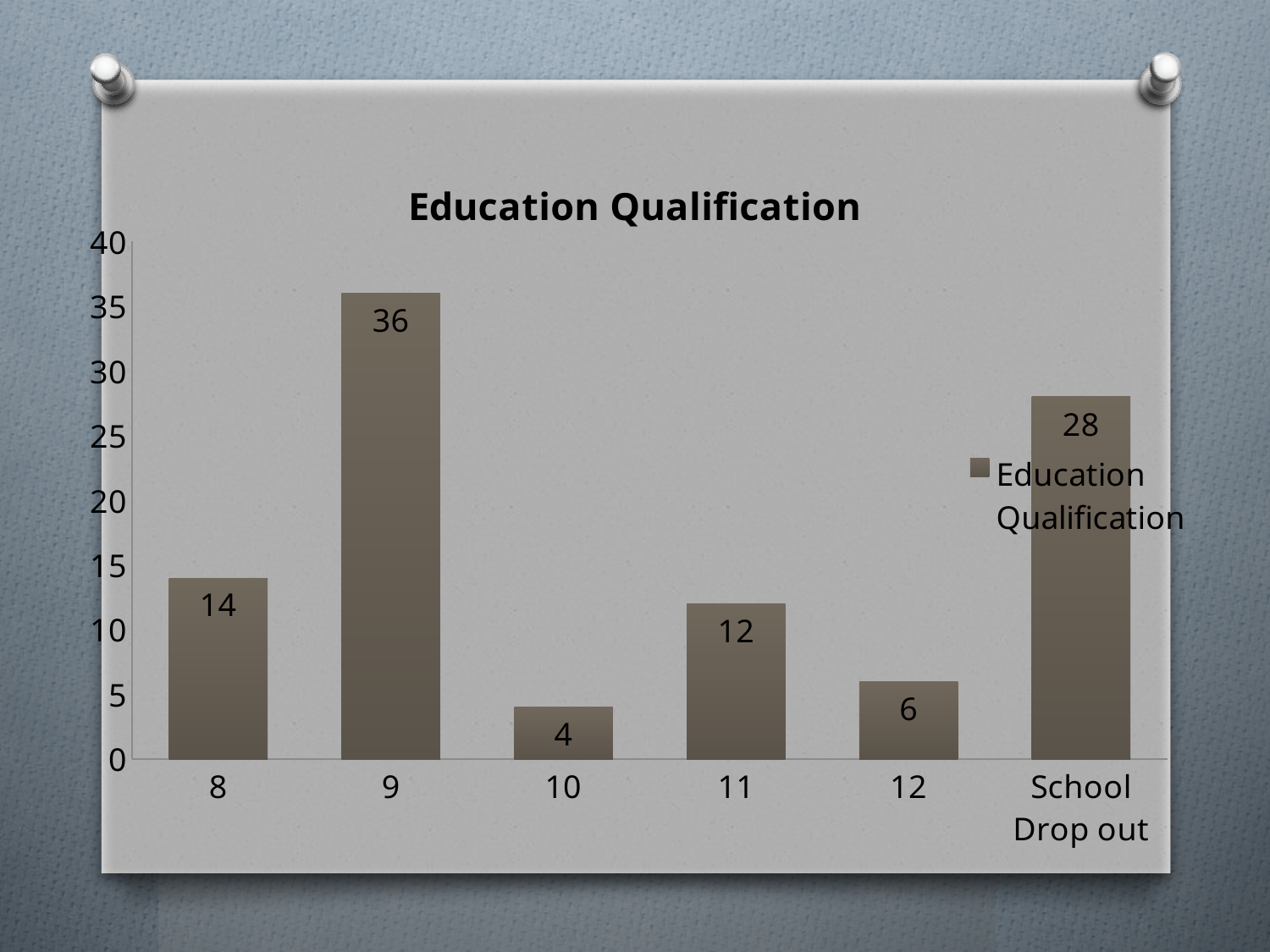
Which category has the highest value? 9 What is the difference between the values for 9 and School Drop out? 8 What is the value for category 9 in the Education Qualification chart? 36 Which category has the lowest value? 10 Is the value for School Drop out greater or less than 25? greater What is the difference between the values for 8 and 12? 8 What is the title of the chart? Education Qualification What kind of chart is shown on the slide? bar chart Which is larger, the value for 8 or the value for 11? 8 How many categories are shown on the x axis? 6 What is the value for category 10? 4 What is the value for School Drop out? 28